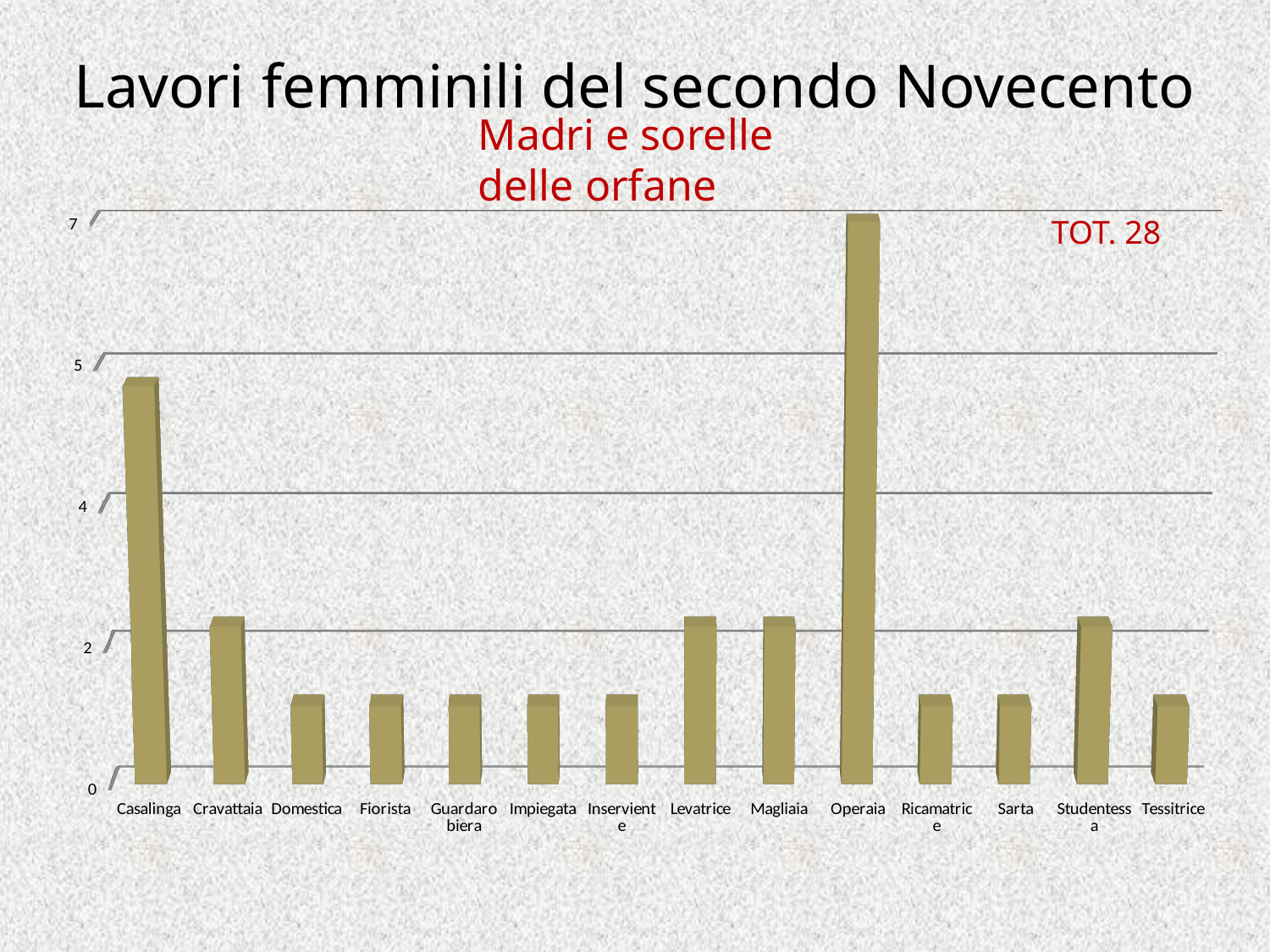
Is the value for Casalinga greater or less than 4? greater Which category has the highest value in the chart? Operaia Which is larger, the value for Operaia or the value for Levatrice? Operaia Is the value for Domestica greater or less than 2? less Is the value for Operaia greater or less than 5? greater How many categories are shown on the x axis of the chart? 14 What is the title of the chart? Madri e sorelle delle orfane What total is written in red text on the chart? TOT. 28 What kind of chart is shown on the slide? bar chart Which is larger, the value for Casalinga or the value for Cravattaia? Casalinga